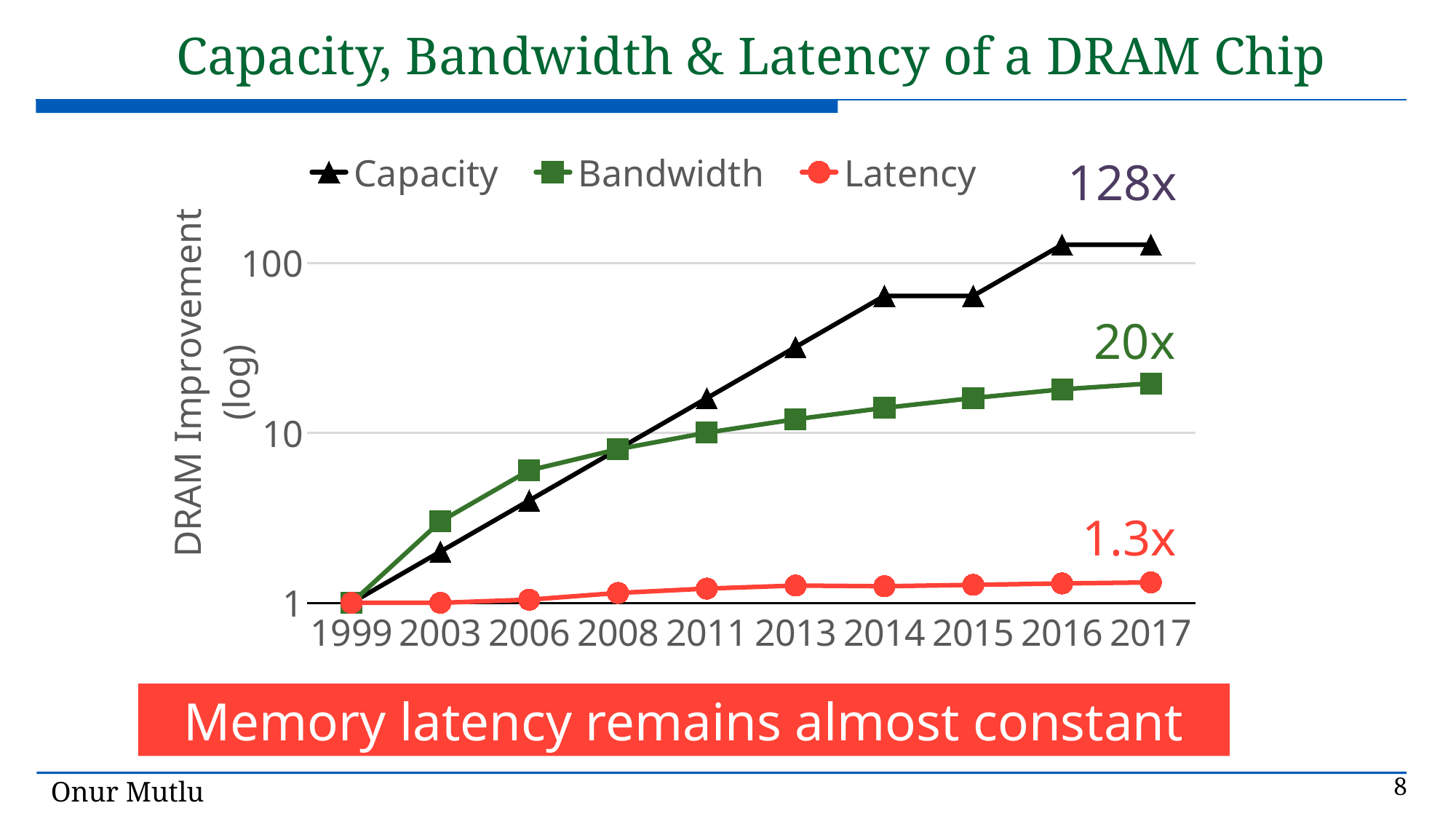
In 2006, which is larger, Capacity or Bandwidth? Bandwidth How many series does the legend list? 3 What is the Bandwidth improvement in 2017? 20x What is the Capacity improvement in 2017? 128x Which series has the lowest value in 2017? Latency Is the Capacity value for 2014 greater or less than 10? greater What is the label on the y axis? DRAM Improvement (log) Does the Capacity series rise or fall from 1999 to 2017? rise How many years are plotted along the x axis? 10 What is the Latency improvement in 2017? 1.3x Which series has the highest value in 2017? Capacity What kind of chart is shown on the slide? line chart